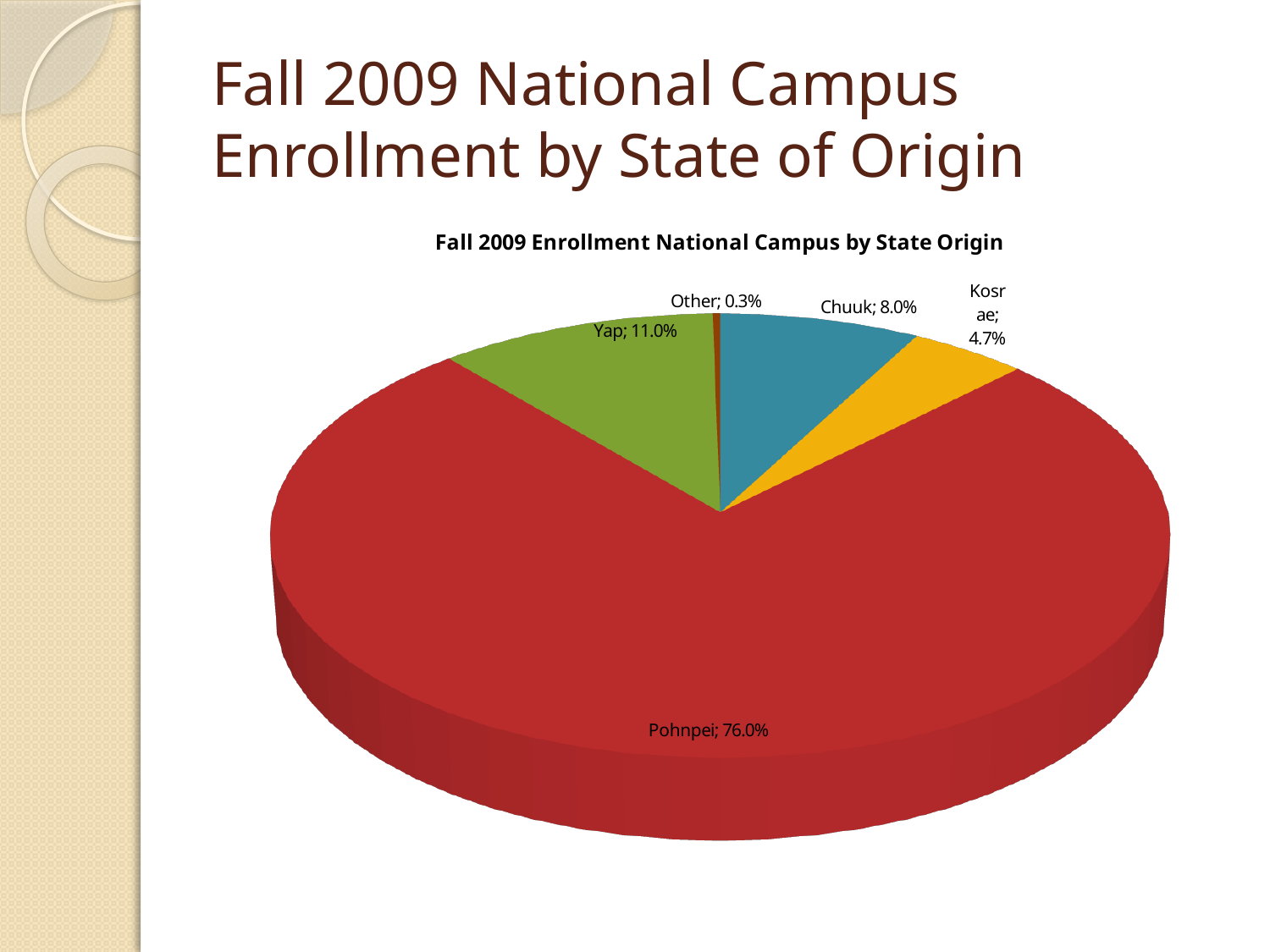
What is the title of the chart? Fall 2009 Enrollment National Campus by State Origin What is the difference in percentage points between the Chuuk and Kosrae shares? 3.3 Which state has the largest share of enrollment? Pohnpei What kind of chart is shown on the slide? pie chart Which has a larger share of enrollment, Yap or Chuuk? Yap What share of enrollment is labelled Other? 0.3% What share of enrollment comes from Pohnpei? 76.0% What share of enrollment comes from Kosrae? 4.7% How many slices does the pie chart have? 5 What share of enrollment comes from Chuuk? 8.0% What share of enrollment comes from Yap? 11.0% Which category has the smallest share of enrollment? Other